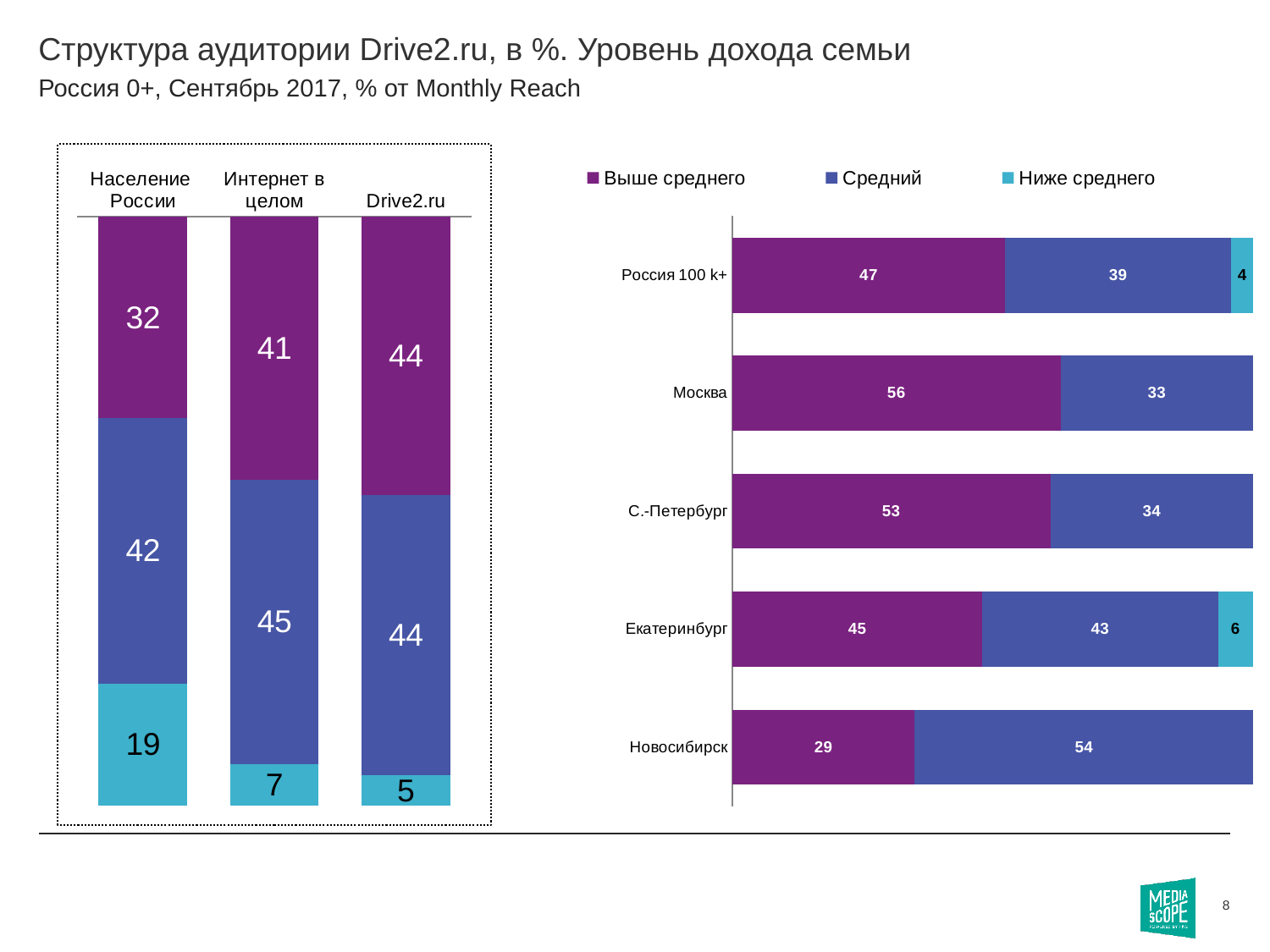
In the right chart, how many cities/regions are listed on the vertical axis? 5 In the right chart, which is larger: the 'Средний' value for Екатеринбург or for С.-Петербург? Екатеринбург In the left chart, what is the value of the 'Ниже среднего' segment for Население России? 19 In the right chart, what is the 'Выше среднего' value for Москва? 56 In the right chart, what is the 'Средний' value for Новосибирск? 54 How many series does the legend of the right chart list? 3 In the left chart, what is the difference between the 'Ниже среднего' values for Население России and Drive2.ru? 14 What type of chart is the right chart? Stacked bar chart In the right chart, which city has the highest 'Выше среднего' value? Москва In the right chart, which category has the lowest 'Выше среднего' value? Новосибирск In the left chart, what is the value of the 'Выше среднего' segment for Drive2.ru? 44 In the left chart, what is the total of the stacked bar for Интернет в целом? 93